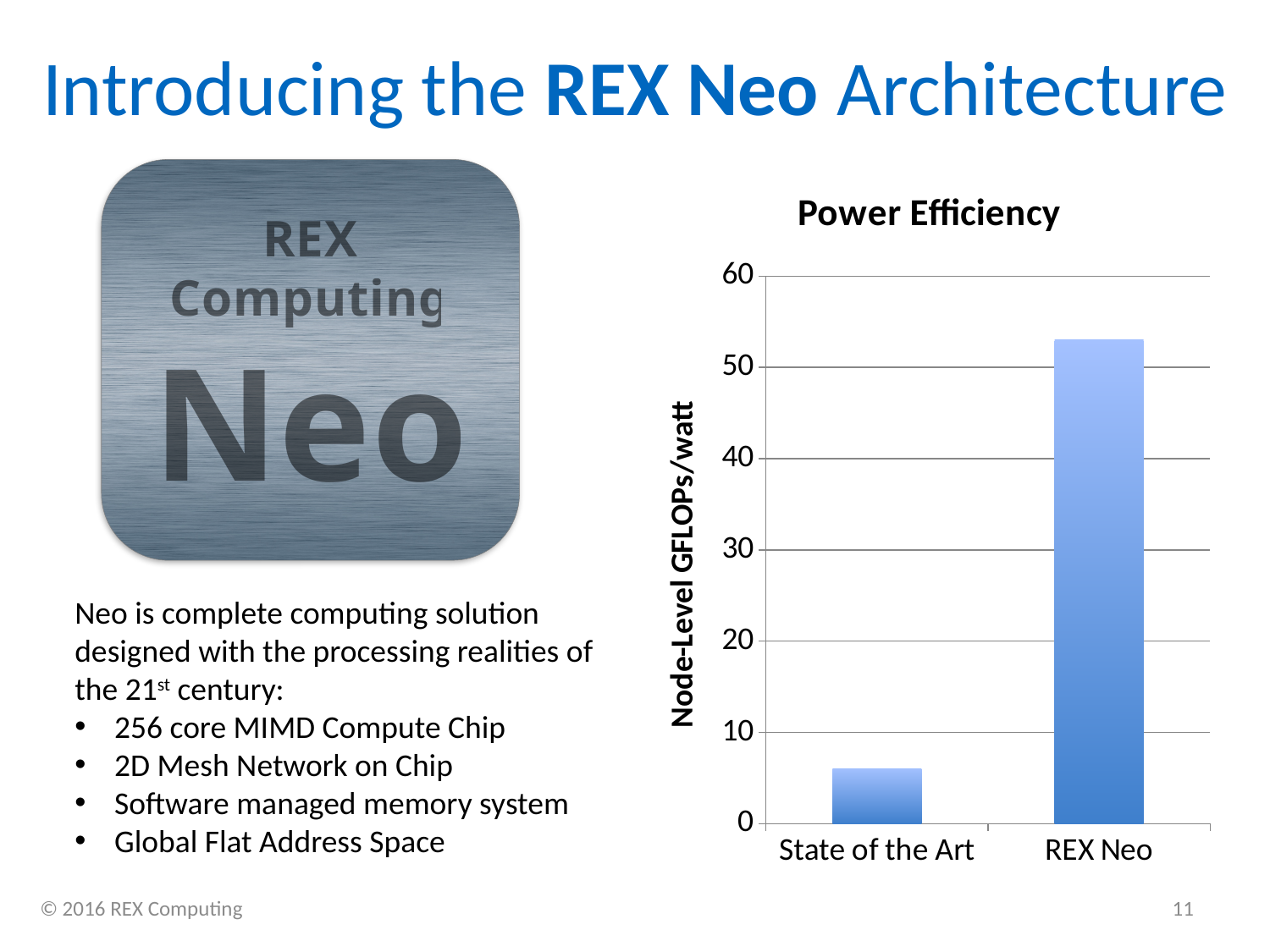
How many categories are plotted in the Power Efficiency chart? 2 Is the value for State of the Art greater or less than 10? less Is the value for REX Neo greater or less than 50? greater Which category has the highest value in the Power Efficiency chart? REX Neo Which has a larger value, State of the Art or REX Neo? REX Neo Is the value for REX Neo greater or less than 60? less Which category has the lowest value in the Power Efficiency chart? State of the Art What kind of chart is shown on the slide? bar chart What is the title of the chart? Power Efficiency Do the values rise or fall from State of the Art to REX Neo along the x axis? rise What is the label of the vertical axis of the chart? Node-Level GFLOPs/watt